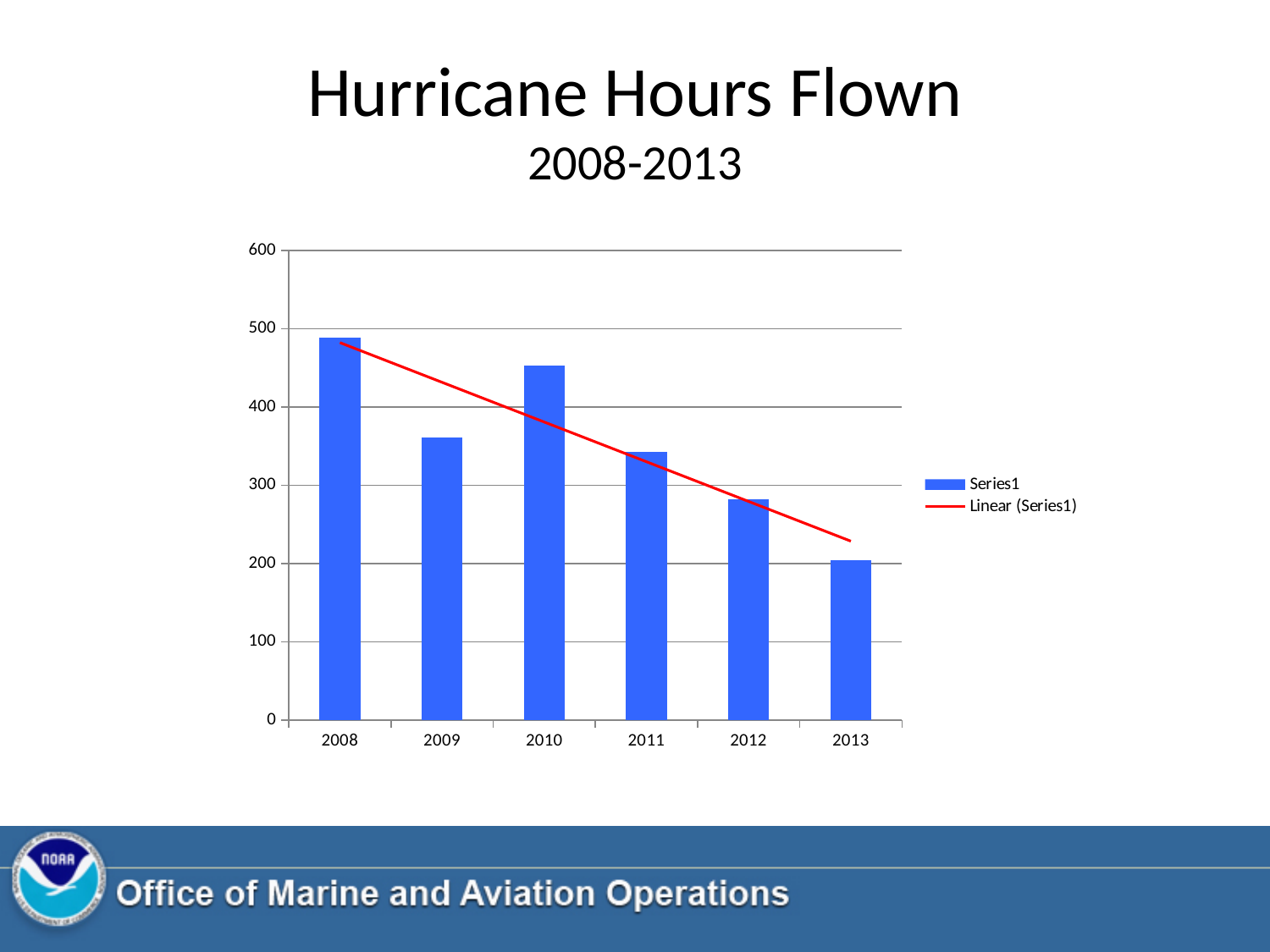
Which year has the lowest number of hurricane hours flown? 2013 What colour is the linear trendline on the chart? Red Does the linear trendline rise or fall from 2008 to 2013? Fall Which year has the highest number of hurricane hours flown? 2008 Is the value for 2013 greater or less than 300? less How many entries does the chart's legend list? 2 Is the value for 2011 greater or less than 400? less What kind of chart is shown on the slide? Bar chart Is the value for 2010 greater or less than 400? greater How many years are shown on the x axis of the chart? 6 Which year has the larger value, 2008 or 2010? 2008